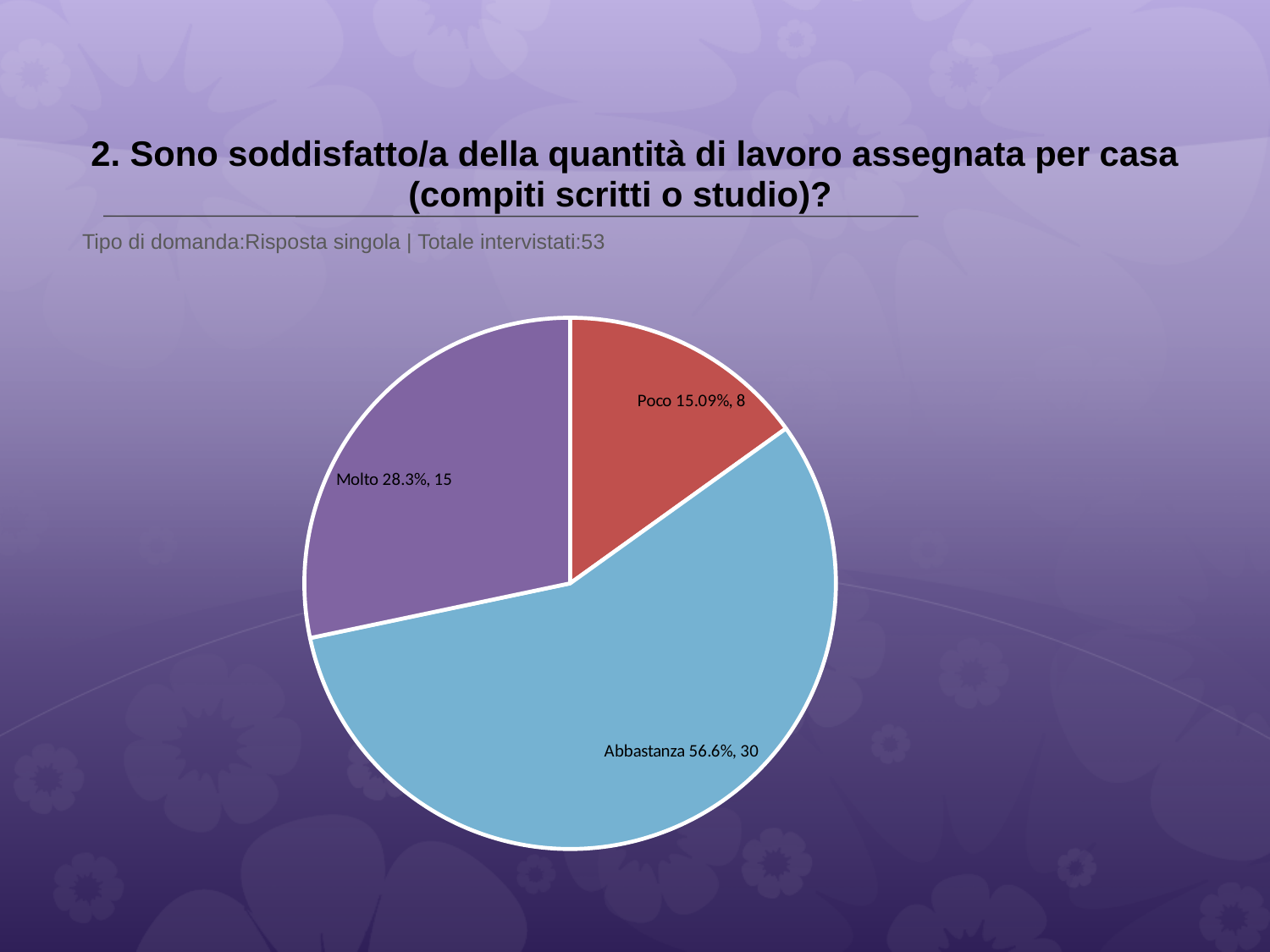
How many respondents answered Abbastanza? 30 How many respondents answered Molto? 15 What is the difference in number of respondents between Abbastanza and Molto? 15 What percentage share does the Molto slice have? 28.3% Which response has the largest slice of the pie? Abbastanza What kind of chart is shown on the slide? pie chart How many respondents answered Poco? 8 What percentage share does the Poco slice have? 15.09% Which response has the smallest slice of the pie? Poco What percentage share does the Abbastanza slice have? 56.6% How many slices does the pie chart have? 3 Which slice is larger, Molto or Poco? Molto